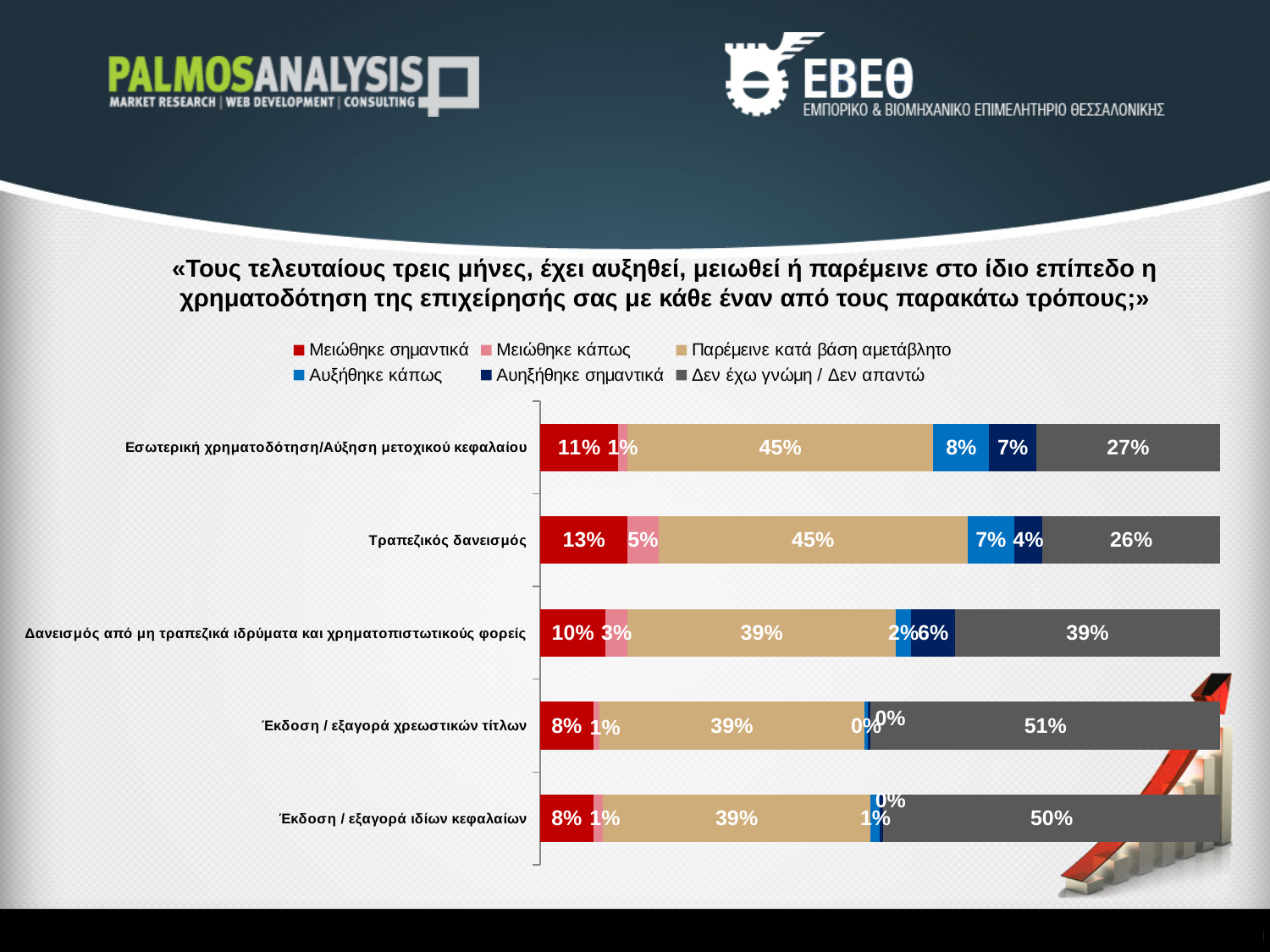
What kind of chart is shown on the slide? Stacked bar chart Which is larger: the 'Μειώθηκε κάπως' value for 'Τραπεζικός δανεισμός' or for 'Δανεισμός από μη τραπεζικά ιδρύματα και χρηματοπιστωτικούς φορείς'? Τραπεζικός δανεισμός Which category has the highest value for 'Μειώθηκε σημαντικά'? Τραπεζικός δανεισμός What is the value of 'Παρέμεινε κατά βάση αμετάβλητο' for 'Τραπεζικός δανεισμός'? 45% What is the value of 'Αυξήθηκε σημαντικά' for 'Δανεισμός από μη τραπεζικά ιδρύματα και χρηματοπιστωτικούς φορείς'? 6% How many categories (financing methods) are shown on the chart? 5 Which category has the lowest value for 'Δεν έχω γνώμη / Δεν απαντώ'? Τραπεζικός δανεισμός What is the value of 'Δεν έχω γνώμη / Δεν απαντώ' for 'Έκδοση / εξαγορά χρεωστικών τίτλων'? 51% Which colour represents 'Παρέμεινε κατά βάση αμετάβλητο' in the legend? Tan (beige) What is the difference between the 'Δεν έχω γνώμη / Δεν απαντώ' values for 'Έκδοση / εξαγορά χρεωστικών τίτλων' and 'Εσωτερική χρηματοδότηση/Αύξηση μετοχικού κεφαλαίου'? 24% What is the value of 'Μειώθηκε σημαντικά' for 'Εσωτερική χρηματοδότηση/Αύξηση μετοχικού κεφαλαίου'? 11% How many series does the legend list? 6